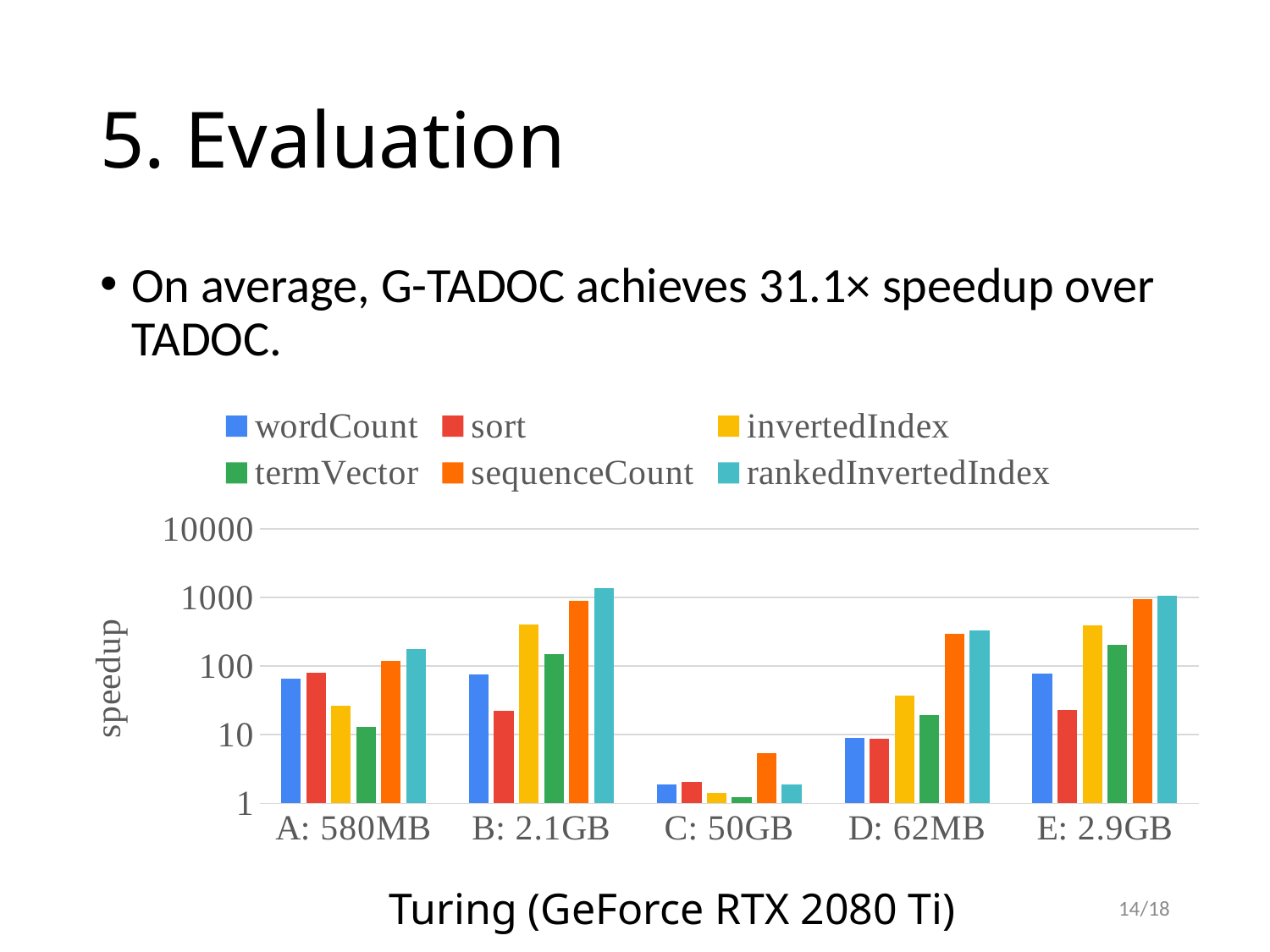
Which series has the highest speedup on dataset B: 2.1GB? rankedInvertedIndex Is the speedup for rankedInvertedIndex on dataset B: 2.1GB greater or less than 1000? greater On dataset C: 50GB, which has the larger speedup, sequenceCount or invertedIndex? sequenceCount Is the speedup for wordCount on dataset A: 580MB greater or less than 100? less How many series does the chart's legend list? 6 How many dataset categories are shown on the x axis of the chart? 5 Is the speedup for sequenceCount on dataset C: 50GB greater or less than 10? less What is the label of the chart's y axis? speedup What kind of chart is shown on the slide? bar chart On dataset B: 2.1GB, which has the larger speedup, rankedInvertedIndex or sort? rankedInvertedIndex